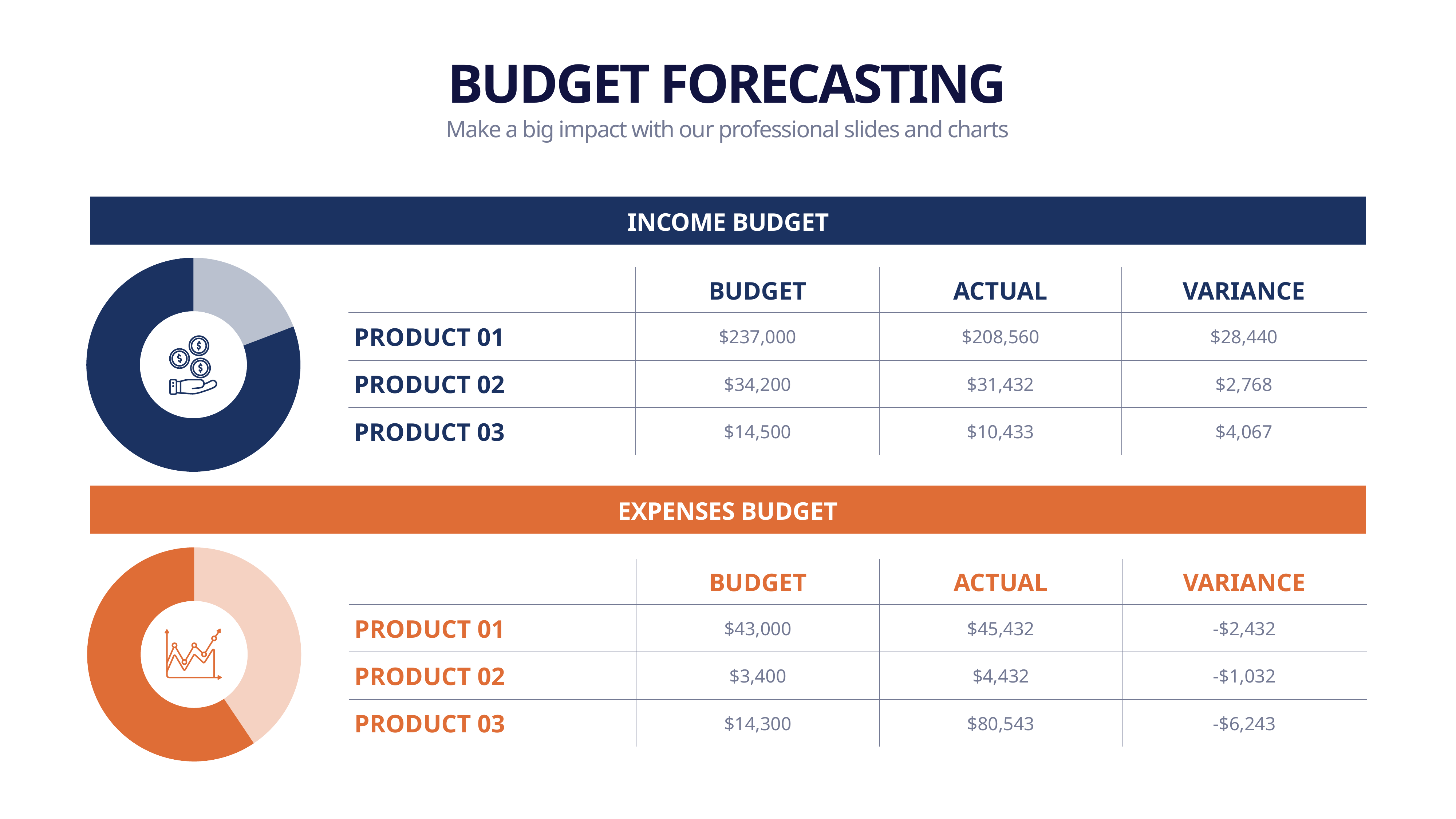
How many doughnut charts are on the slide? 2 In the Income Budget chart, which slice is larger, the dark blue one or the light grey one? dark blue In the Expenses Budget chart, which slice is larger, the dark orange one or the light orange one? dark orange In the Income Budget chart, how many slices does the doughnut have? 2 What kind of chart is shown next to the Expenses Budget table? doughnut chart What colour is the larger slice of the Expenses Budget chart? orange What kind of chart is shown next to the Income Budget table? doughnut chart In the Expenses Budget chart, how many slices does the doughnut have? 2